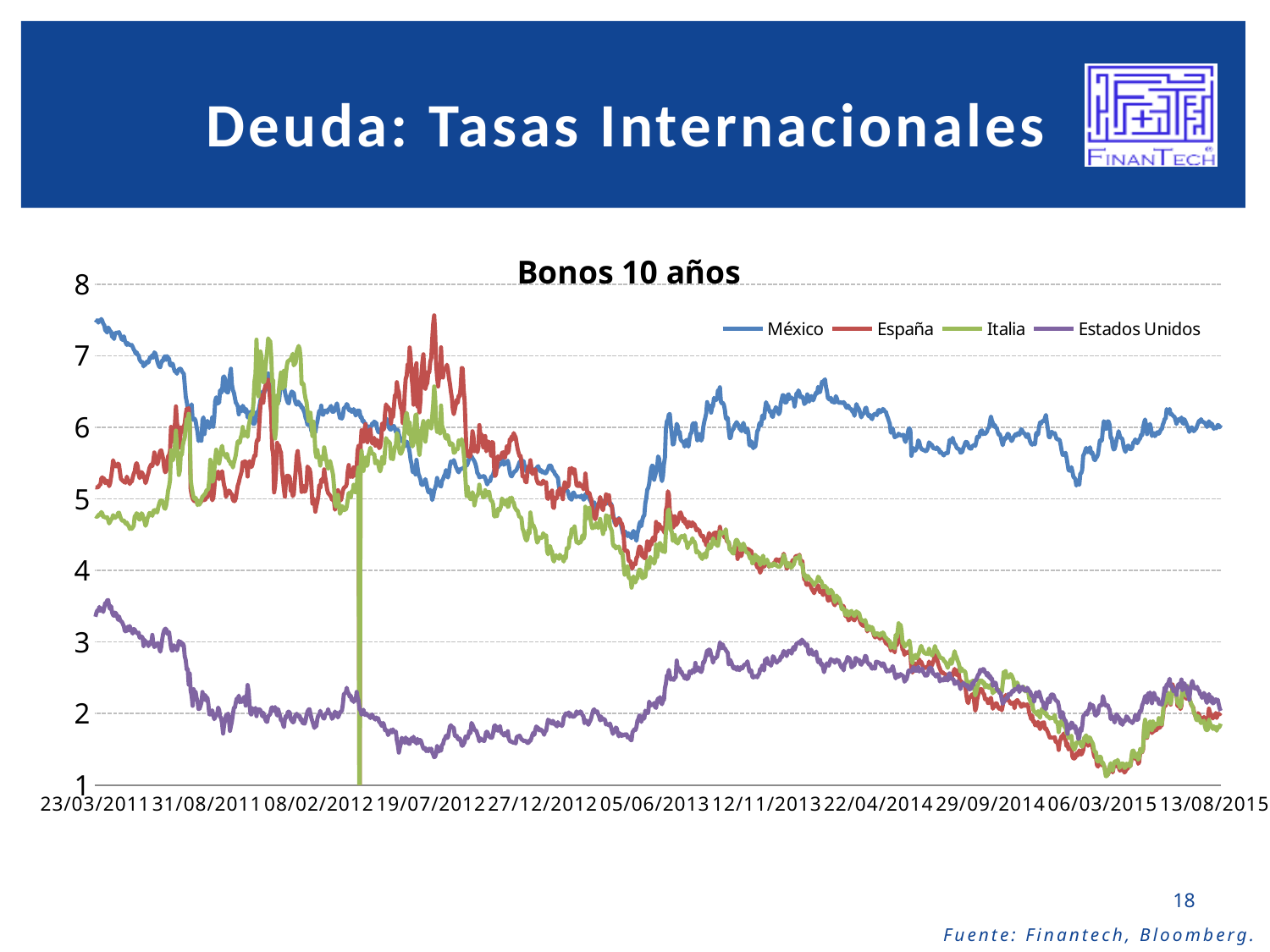
At the start of the period, is the value for Estados Unidos greater or less than 4? less How many series does the legend of the 'Bonos 10 años' chart list? 4 At the end of the period, is the value for España greater or less than 3? less Which series are listed in the legend of the chart? México, España, Italia, Estados Unidos At the end of the period, which is larger, the value for México or the value for España? México At the end of the period, is the value for México greater or less than 5? greater Does the España series rise or fall overall from the start to the end of the period shown? fall What kind of chart is shown on the slide? line chart Which series has the highest value at the end of the period (13/08/2015)? México Which series has the lowest value at the start of the period (23/03/2011)? Estados Unidos Does the Italia series rise or fall overall from the start to the end of the period shown? fall What is the title of the chart? Bonos 10 años